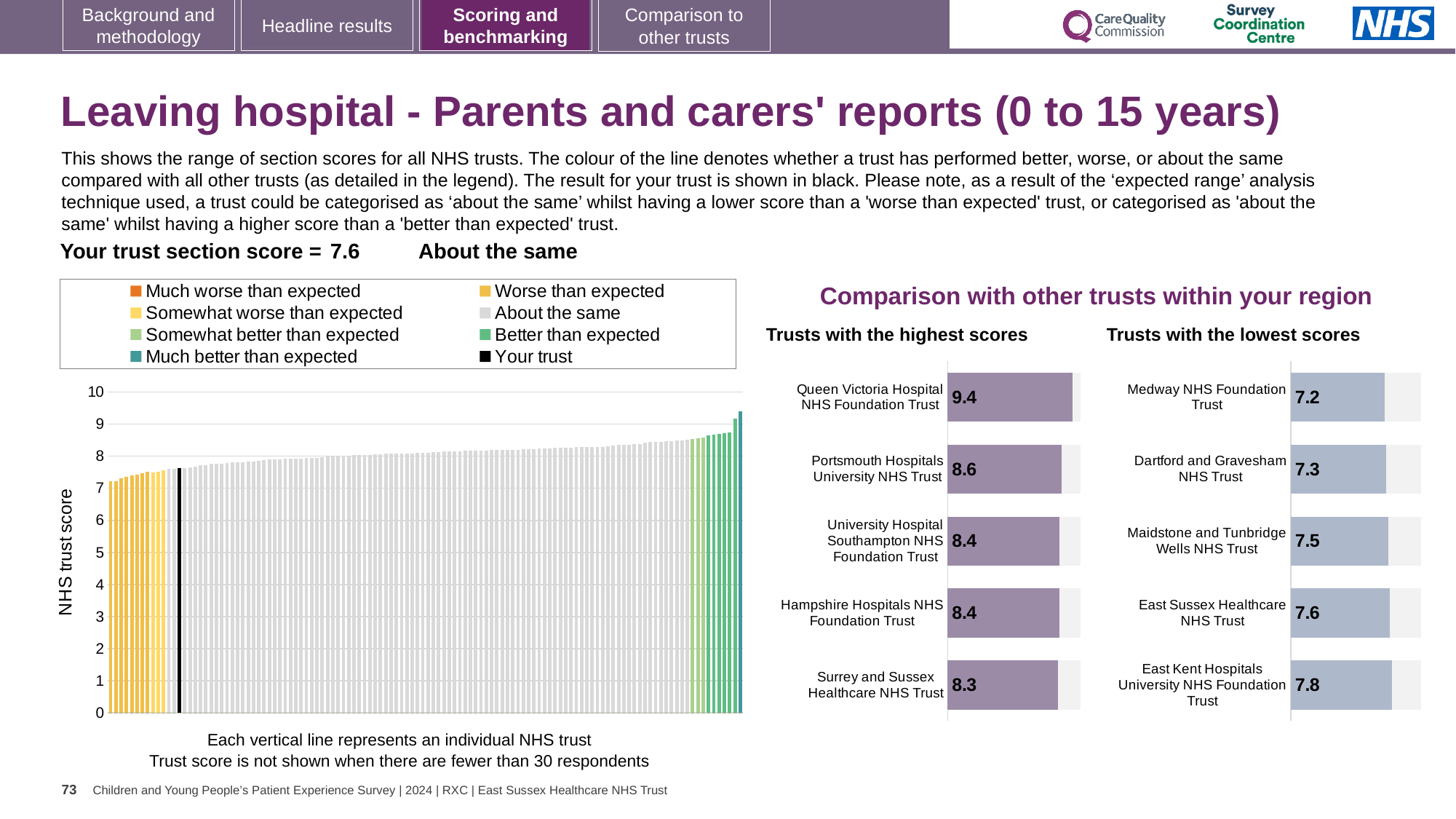
How many entries does the legend above the large chart on the left list? 8 In the 'Trusts with the lowest scores' chart, what is the score for Medway NHS Foundation Trust? 7.2 In the 'Trusts with the lowest scores' chart, what is the difference between the scores of East Kent Hospitals University NHS Foundation Trust and Medway NHS Foundation Trust? 0.6 In the large chart on the left, do the NHS trust scores rise or fall from left to right? Rise In the 'Trusts with the highest scores' chart, which trust has the highest score? Queen Victoria Hospital NHS Foundation Trust In the 'Trusts with the highest scores' chart, what is the score for Queen Victoria Hospital NHS Foundation Trust? 9.4 How many trusts are shown in the 'Trusts with the highest scores' chart? 5 What kind of chart is the large chart on the left showing NHS trust scores? Bar chart In the 'Trusts with the lowest scores' chart, what is the score for East Kent Hospitals University NHS Foundation Trust? 7.8 In the 'Trusts with the lowest scores' chart, which trust has the lowest score? Medway NHS Foundation Trust In the 'Trusts with the lowest scores' chart, which has the higher score: Dartford and Gravesham NHS Trust or Maidstone and Tunbridge Wells NHS Trust? Maidstone and Tunbridge Wells NHS Trust In the 'Trusts with the highest scores' chart, what is the difference between the scores of Queen Victoria Hospital NHS Foundation Trust and Portsmouth Hospitals University NHS Trust? 0.8